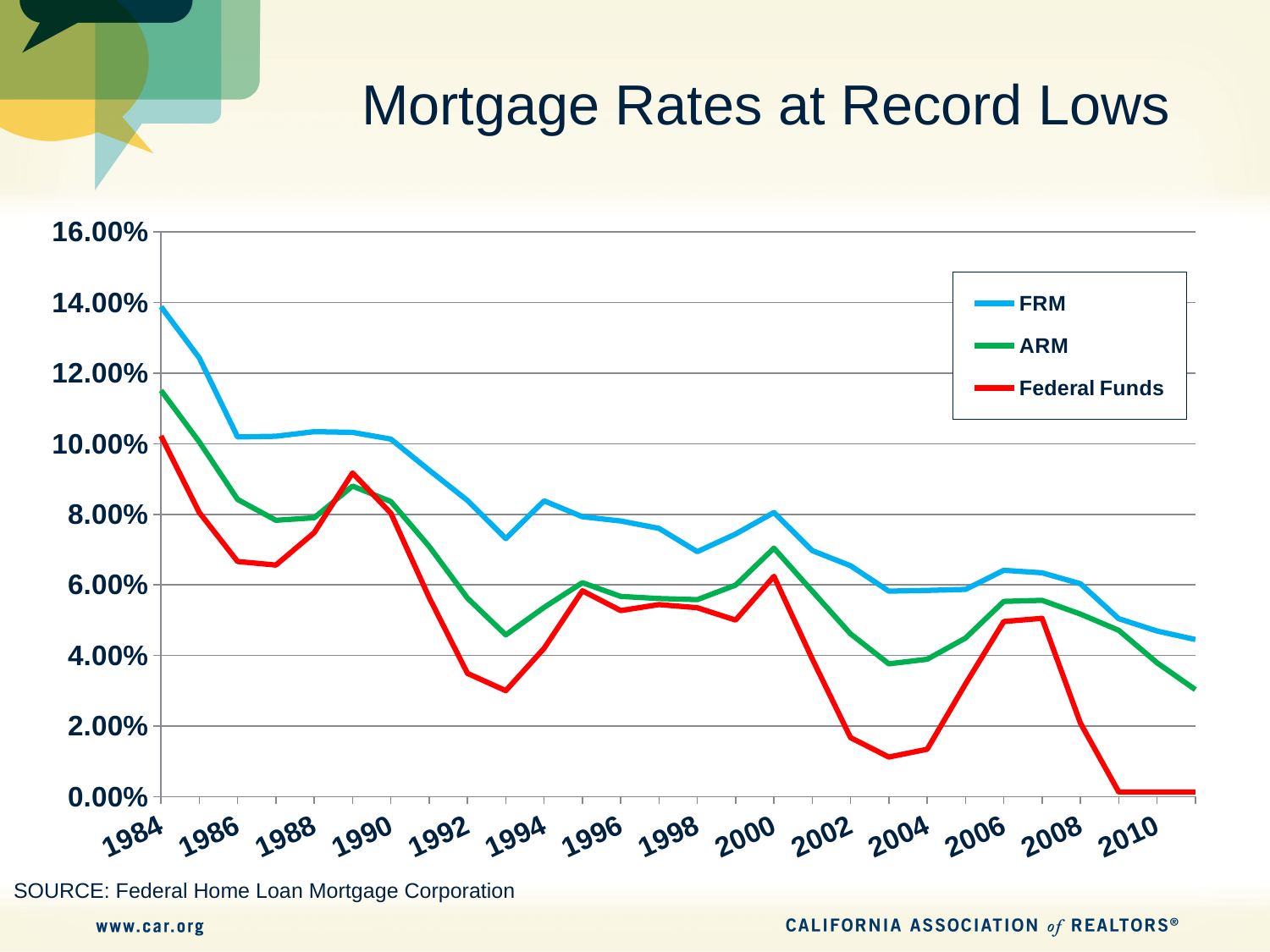
Is the Federal Funds value for 2010 greater or less than 2.00%? less Which series has the highest value in 1984? FRM Is the FRM value for 1984 greater or less than 12.00%? greater What kind of chart is shown on the slide? line chart In 2004, which is larger, the FRM value or the Federal Funds value? FRM How many series does the legend list? 3 Overall, does the FRM line rise or fall from 1984 to 2010? fall What is the title of the chart? Mortgage Rates at Record Lows Is the ARM value for 1984 greater or less than 10.00%? greater Which series is drawn in red? Federal Funds Which series has the lowest value in 2010? Federal Funds